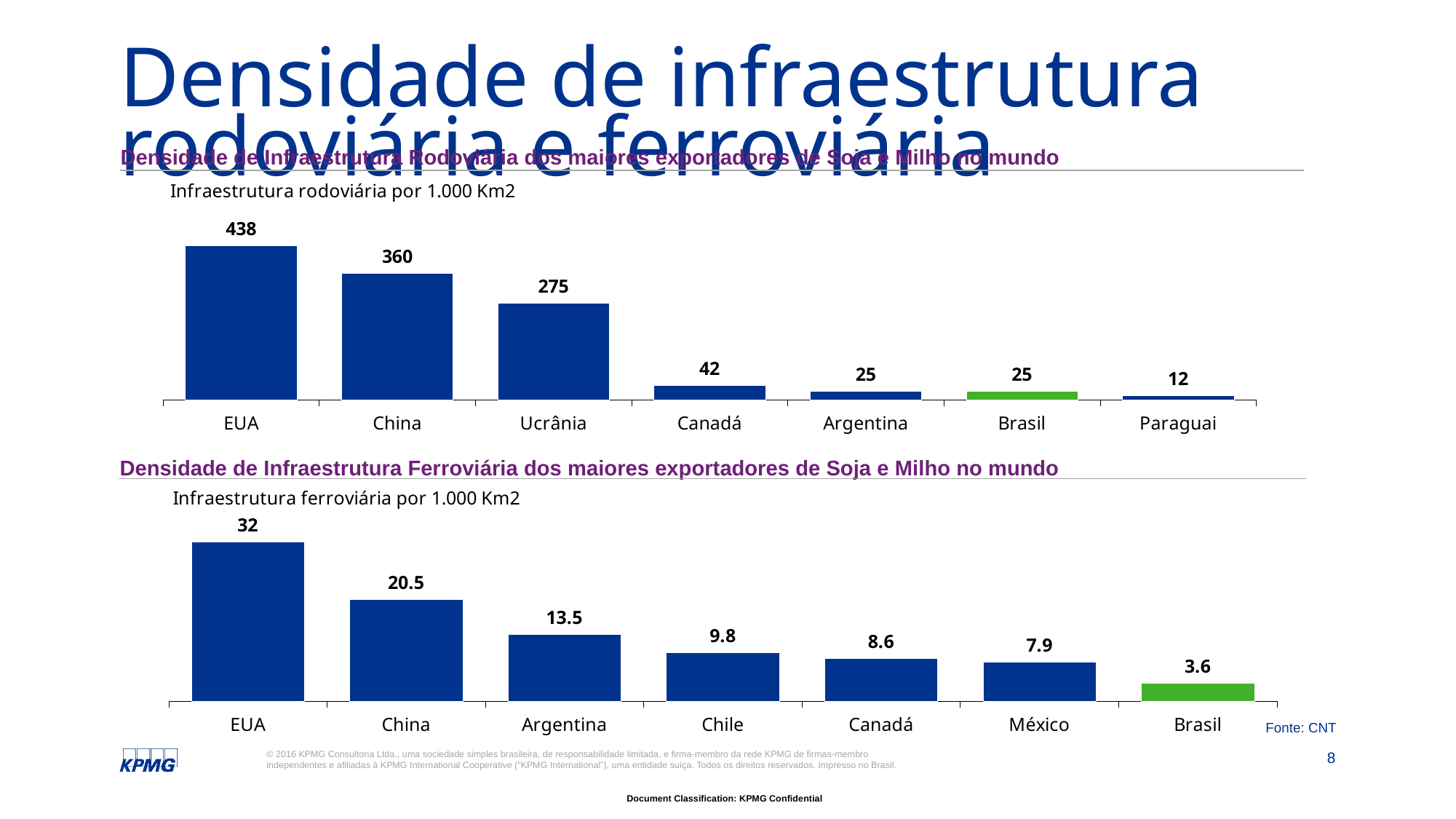
In the bottom chart (Infraestrutura ferroviária por 1.000 Km2), what is the value for Chile? 9.8 In the top chart (Infraestrutura rodoviária por 1.000 Km2), what is the value for Brasil? 25 In the bottom chart (Infraestrutura ferroviária por 1.000 Km2), what is the difference between the values for EUA and China? 11.5 In the top chart (Infraestrutura rodoviária por 1.000 Km2), which country has the lowest value? Paraguai In the top chart (Infraestrutura rodoviária por 1.000 Km2), which country has the highest value? EUA In the bottom chart (Infraestrutura ferroviária por 1.000 Km2), which country has the lowest value? Brasil In the top chart (Infraestrutura rodoviária por 1.000 Km2), how many countries are shown? 7 In the bottom chart (Infraestrutura ferroviária por 1.000 Km2), which country's bar is coloured green? Brasil In the top chart (Infraestrutura rodoviária por 1.000 Km2), what is the difference between the values for EUA and Ucrânia? 163 What type of chart is the bottom chart (Infraestrutura ferroviária por 1.000 Km2)? Bar chart In the bottom chart (Infraestrutura ferroviária por 1.000 Km2), which is larger, the value for Canadá or the value for México? Canadá In the top chart (Infraestrutura rodoviária por 1.000 Km2), what is the value for China? 360